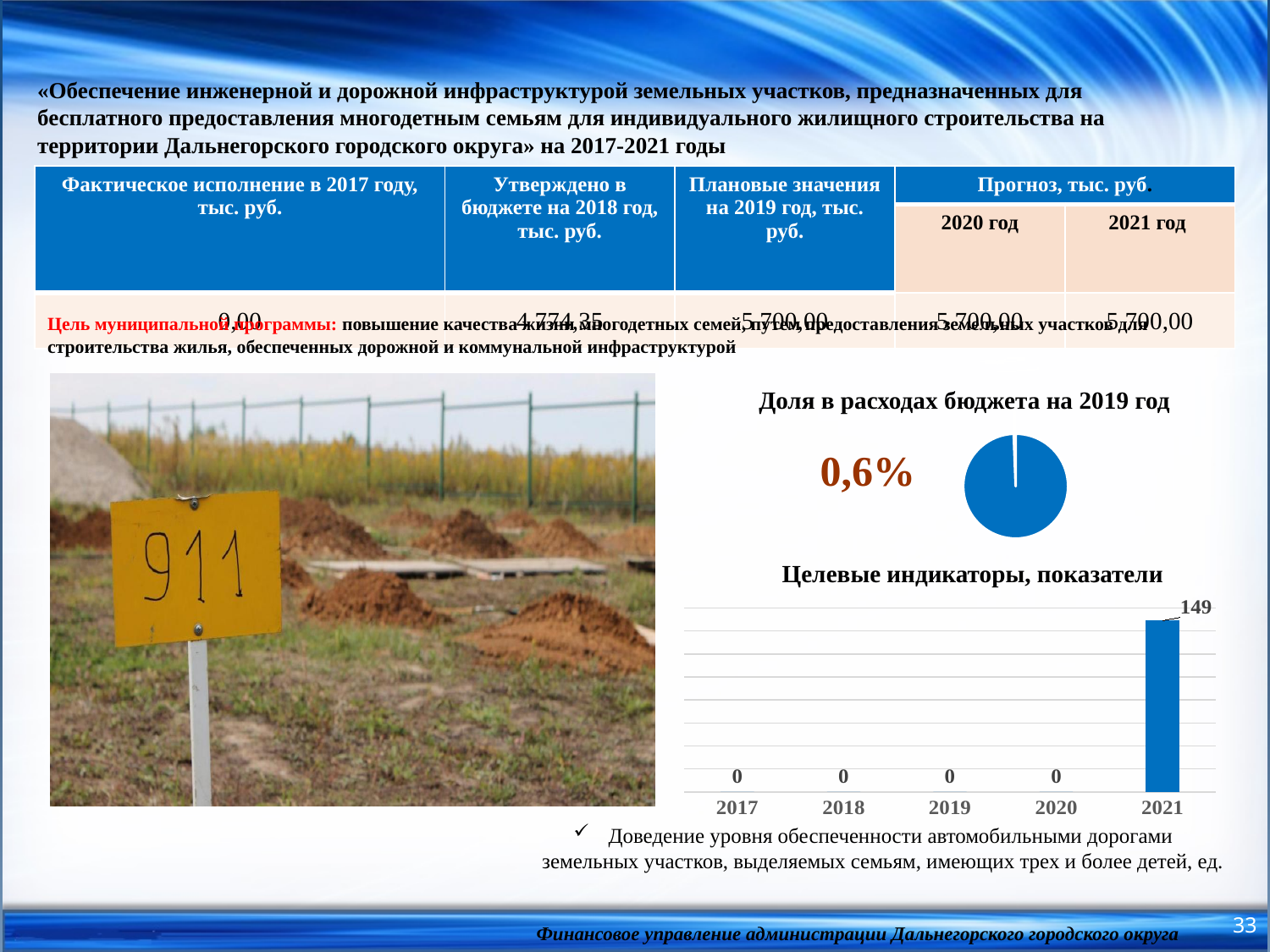
In the chart titled «Целевые индикаторы, показатели», what is the value for 2021? 149 In the chart titled «Целевые индикаторы, показатели», how many years are shown on the x axis? 5 In the chart titled «Целевые индикаторы, показатели», what is the value for 2019? 0 What kind of chart is the one titled «Доля в расходах бюджета на 2019 год»? pie chart What kind of chart is the one titled «Целевые индикаторы, показатели»? bar chart In the chart titled «Целевые индикаторы, показатели», do the values rise or fall from 2020 to 2021? rise What is the title of the bar chart on the slide? Целевые индикаторы, показатели In the chart titled «Целевые индикаторы, показатели», which is larger, the value for 2021 or the value for 2018? 2021 In the chart titled «Целевые индикаторы, показатели», how many years have a value of 0? 4 In the chart titled «Целевые индикаторы, показатели», which year has the highest value? 2021 In the chart titled «Целевые индикаторы, показатели», what is the difference between the values for 2021 and 2020? 149 What share is shown next to the pie chart titled «Доля в расходах бюджета на 2019 год»? 0,6%